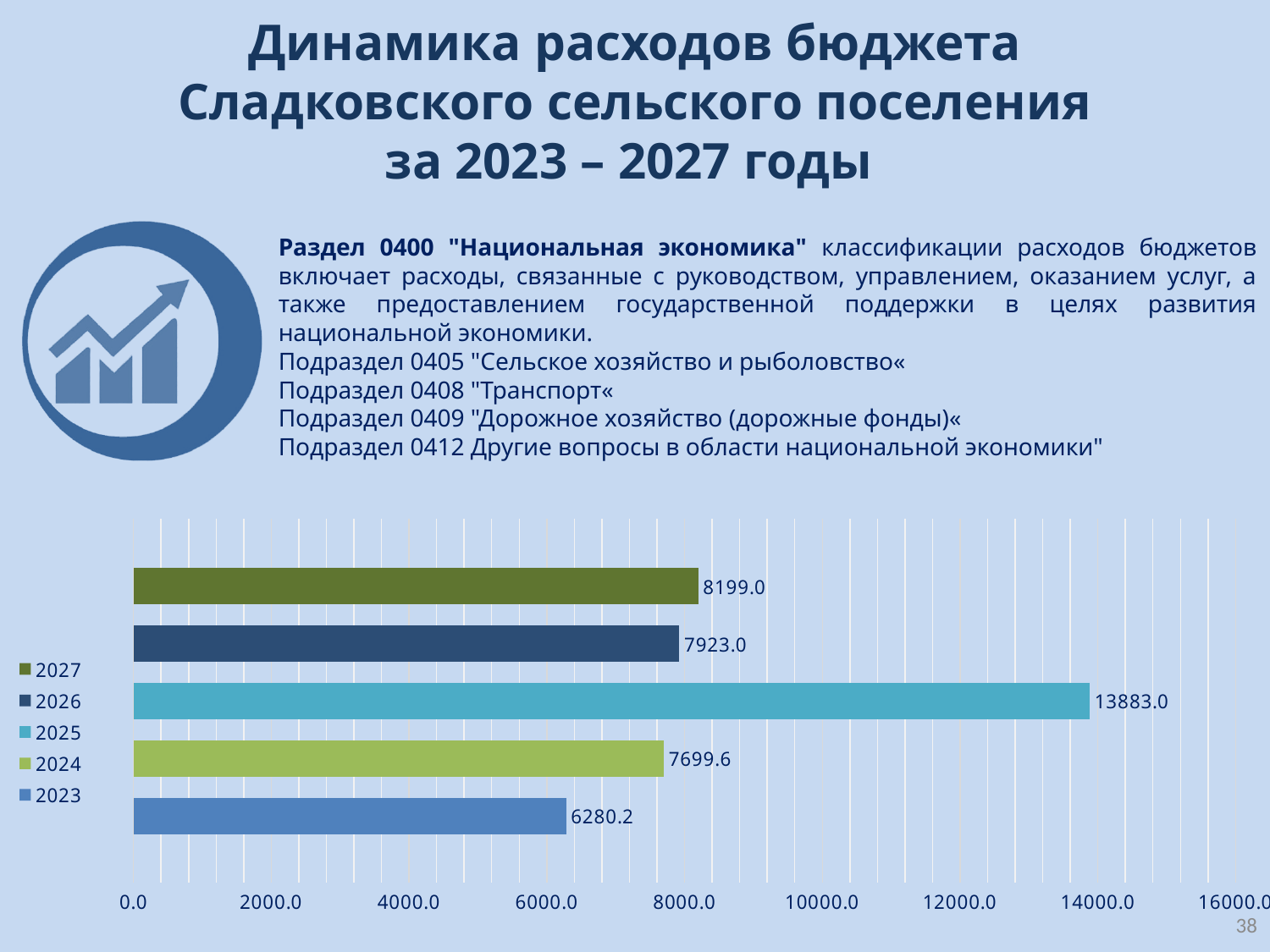
Which is larger, the value for 2027 or the value for 2026? 2027 What is the difference between the values for 2024 and 2023? 1419.4 Which year has the lowest value in the bar chart? 2023 What is the value for 2023 in the bar chart? 6280.2 What is the difference between the values for 2025 and 2026? 5960.0 What is the value for 2027 in the bar chart? 8199.0 What is the value for 2025 in the bar chart? 13883.0 What kind of chart is shown on the slide? bar chart What is the value for 2024 in the bar chart? 7699.6 Which year has the highest value in the bar chart? 2025 How many series does the legend list? 5 Is the value for 2025 greater or less than 12000.0? greater